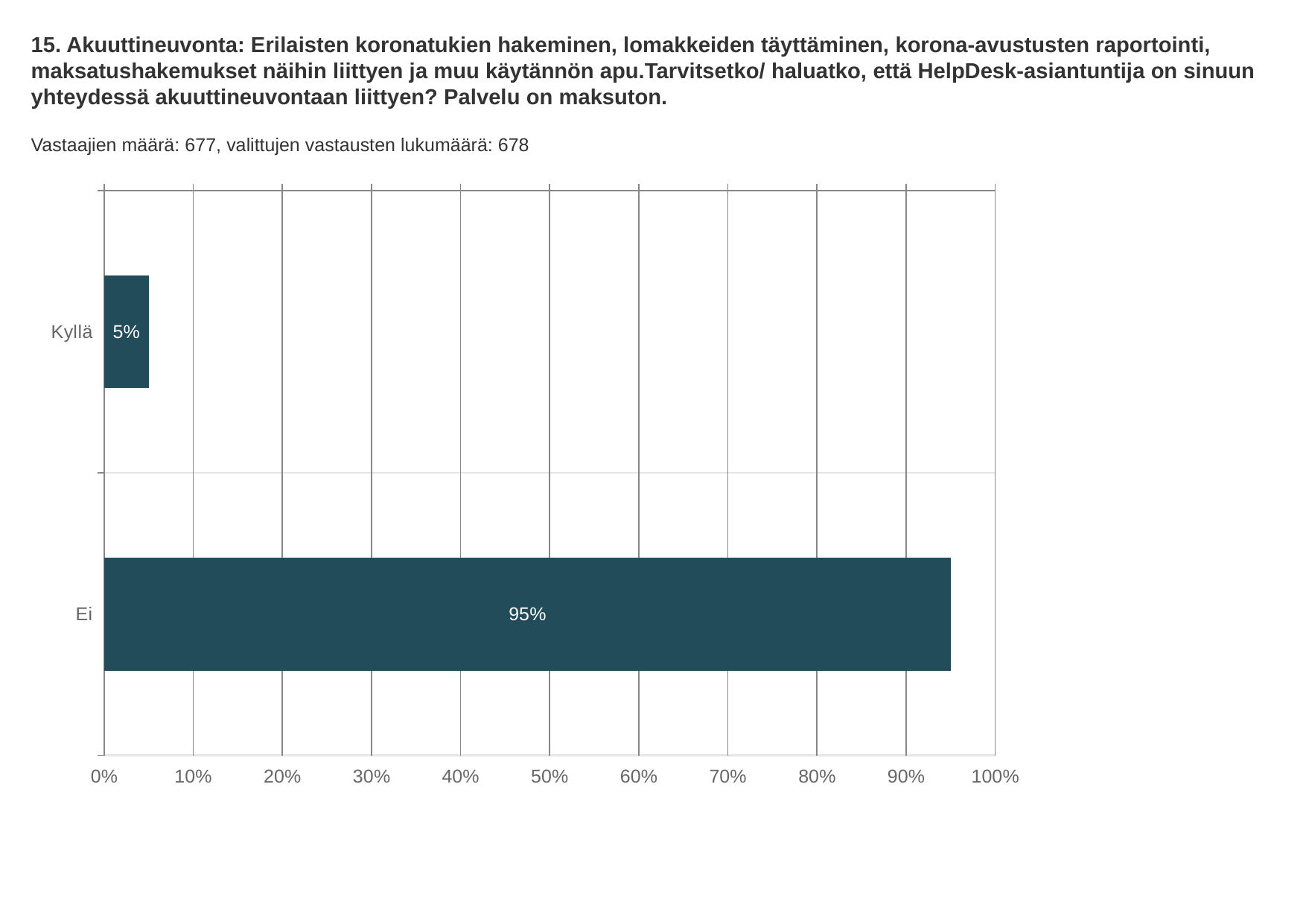
What is the value for Ei? 95% What is the maximum value shown on the x axis? 100% What is the number of respondents (Vastaajien määrä) stated on the slide? 677 Which category has the lowest value? Kyllä Which is larger, the value for Kyllä or the value for Ei? Ei What is the difference between the values for Ei and Kyllä? 90% Which category has the highest value? Ei Is the value for Kyllä greater or less than 10%? less Is the value for Ei greater or less than 90%? greater What kind of chart is shown on the slide? bar chart What is the value for Kyllä? 5% How many categories are shown in the chart? 2